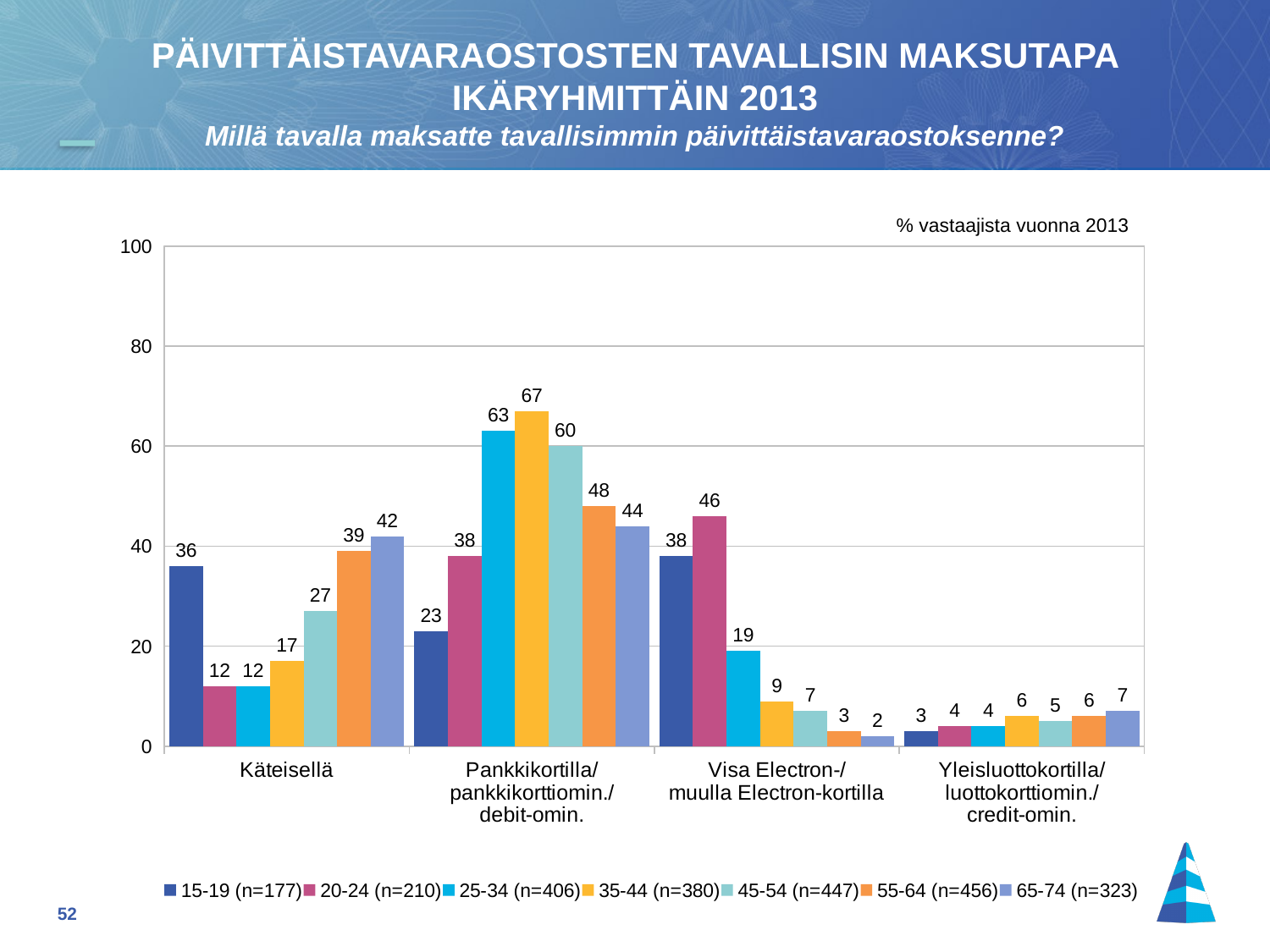
What is the difference between the 35-44 and 15-19 values in the Pankkikortilla/pankkikorttiomin./debit-omin. category? 44 Which age group has the lowest value in the Visa Electron-/muulla Electron-kortilla category? 65-74 (n=323) How many age-group series does the legend list? 7 What type of chart is shown on the slide? Bar chart What percentage of 15-19 year olds pay most commonly with cash (Käteisellä)? 36 Which age group has the highest value in the Käteisellä category? 65-74 (n=323) What is the value for the 20-24 age group in the Visa Electron-/muulla Electron-kortilla category? 46 How many payment method categories are shown on the x axis? 4 What is the value for the 35-44 age group in the Pankkikortilla/pankkikorttiomin./debit-omin. category? 67 In the Käteisellä category, which is larger: the value for 45-54 or the value for 35-44? 45-54 What is the sample size (n) for the 45-54 age group shown in the legend? n=447 Do the values for the Visa Electron-/muulla Electron-kortilla category rise or fall as the age groups get older from 20-24 to 65-74? Fall